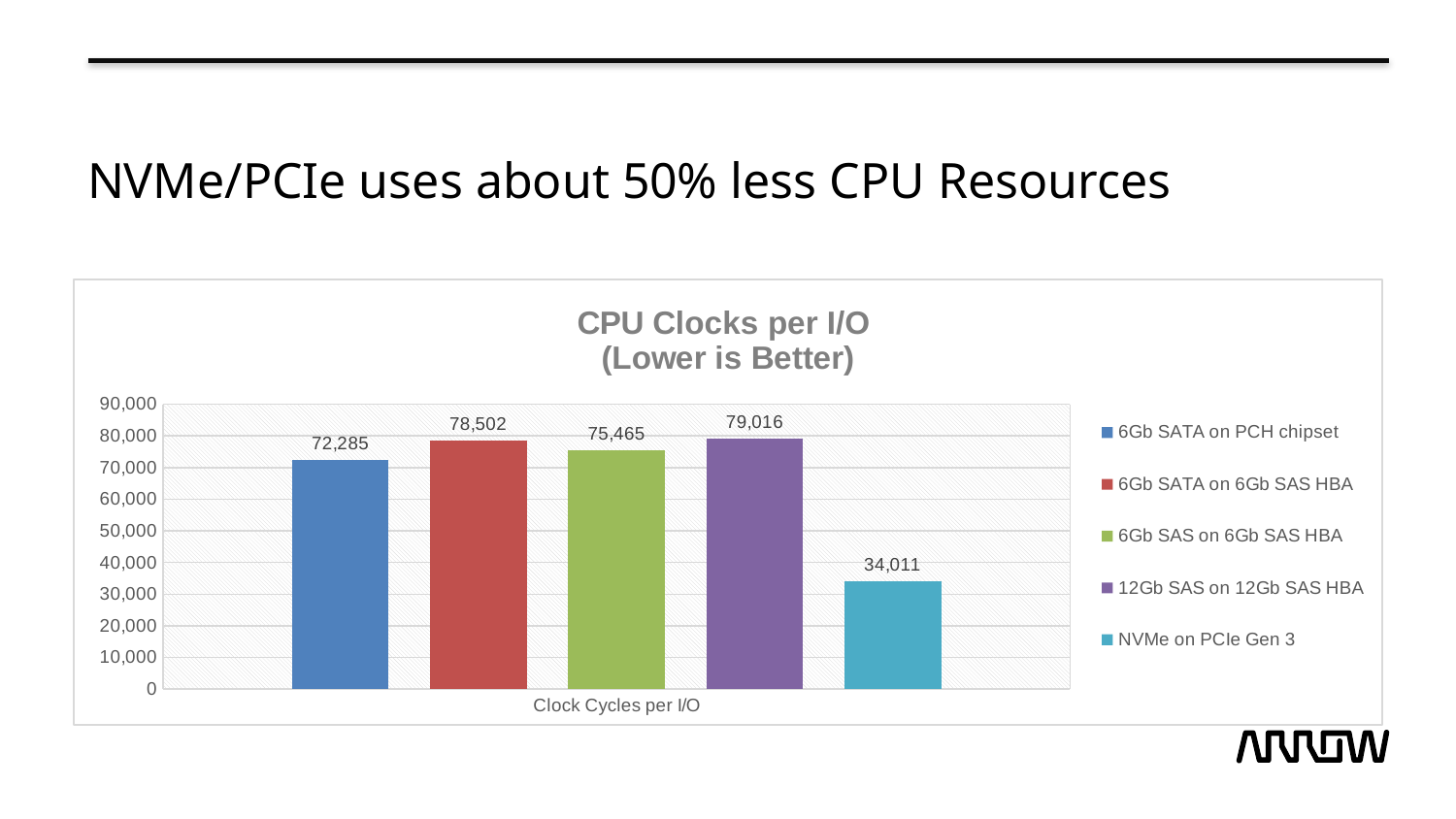
How many series does the legend list? 5 What is the value for NVMe on PCIe Gen 3? 34,011 What is the difference between the values for 6Gb SATA on 6Gb SAS HBA and 6Gb SATA on PCH chipset? 6,217 What kind of chart is shown on the slide? bar chart What is the value for 6Gb SAS on 6Gb SAS HBA? 75,465 What is the difference between the values for 12Gb SAS on 12Gb SAS HBA and NVMe on PCIe Gen 3? 45,005 Which series has the highest value? 12Gb SAS on 12Gb SAS HBA What is the value for 6Gb SATA on PCH chipset? 72,285 Which series has the lowest value? NVMe on PCIe Gen 3 Is the value for NVMe on PCIe Gen 3 greater or less than 40,000? less Which is larger, the value for 6Gb SATA on 6Gb SAS HBA or the value for 6Gb SAS on 6Gb SAS HBA? 6Gb SATA on 6Gb SAS HBA What is the value for 12Gb SAS on 12Gb SAS HBA? 79,016